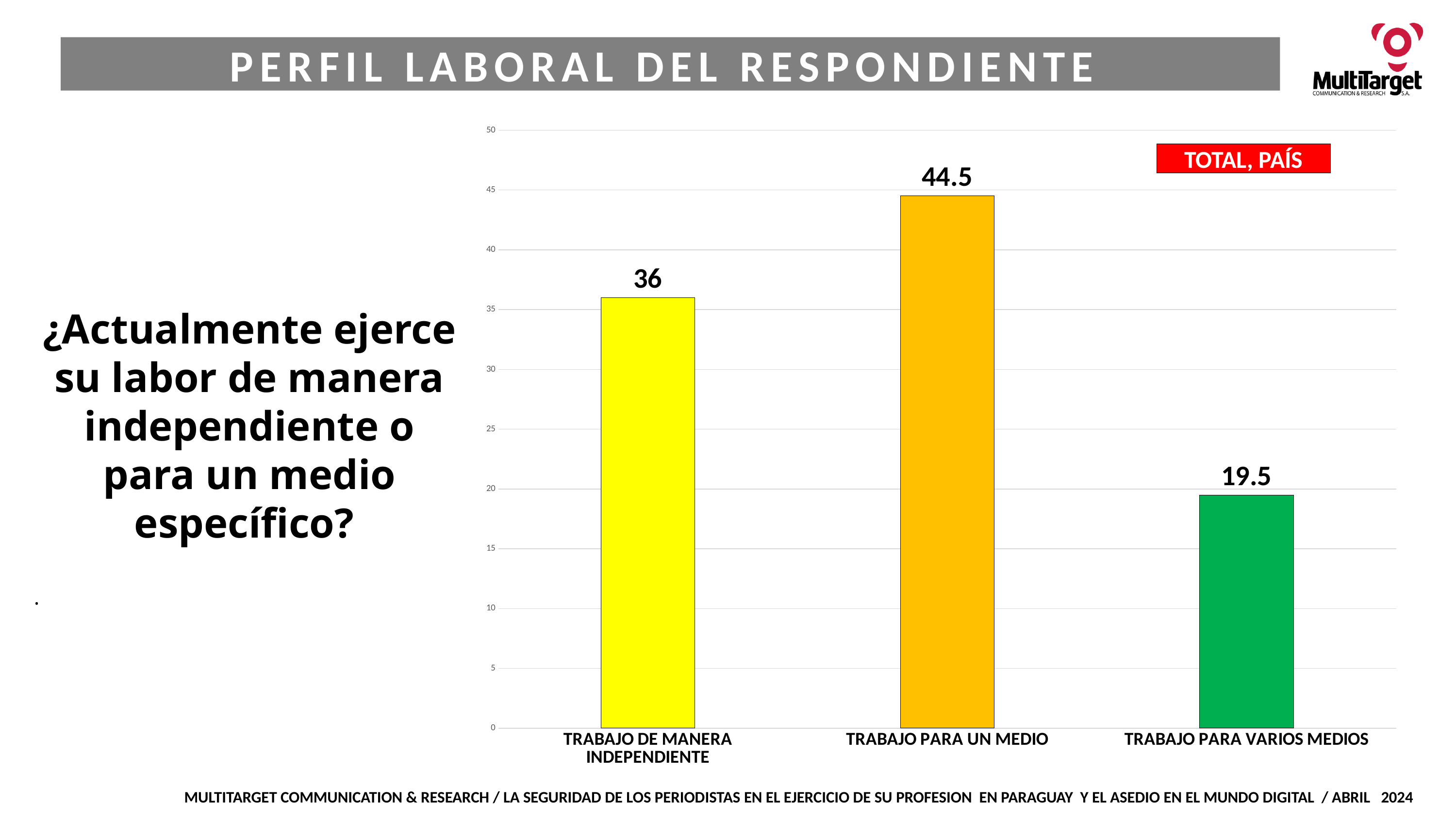
How many categories are shown in the chart? 3 What is the difference between the values for TRABAJO PARA UN MEDIO and TRABAJO DE MANERA INDEPENDIENTE? 8.5 What is the difference between the values for TRABAJO DE MANERA INDEPENDIENTE and TRABAJO PARA VARIOS MEDIOS? 16.5 What colour is the bar for TRABAJO PARA VARIOS MEDIOS? green Which is larger, the value for TRABAJO DE MANERA INDEPENDIENTE or the value for TRABAJO PARA VARIOS MEDIOS? TRABAJO DE MANERA INDEPENDIENTE What is the value for TRABAJO PARA UN MEDIO? 44.5 What is the value for TRABAJO PARA VARIOS MEDIOS? 19.5 What is the value for TRABAJO DE MANERA INDEPENDIENTE? 36 Which category has the highest value? TRABAJO PARA UN MEDIO Which category has the lowest value? TRABAJO PARA VARIOS MEDIOS What kind of chart is shown on the slide? bar chart Is the value for TRABAJO PARA UN MEDIO greater or less than 40? greater